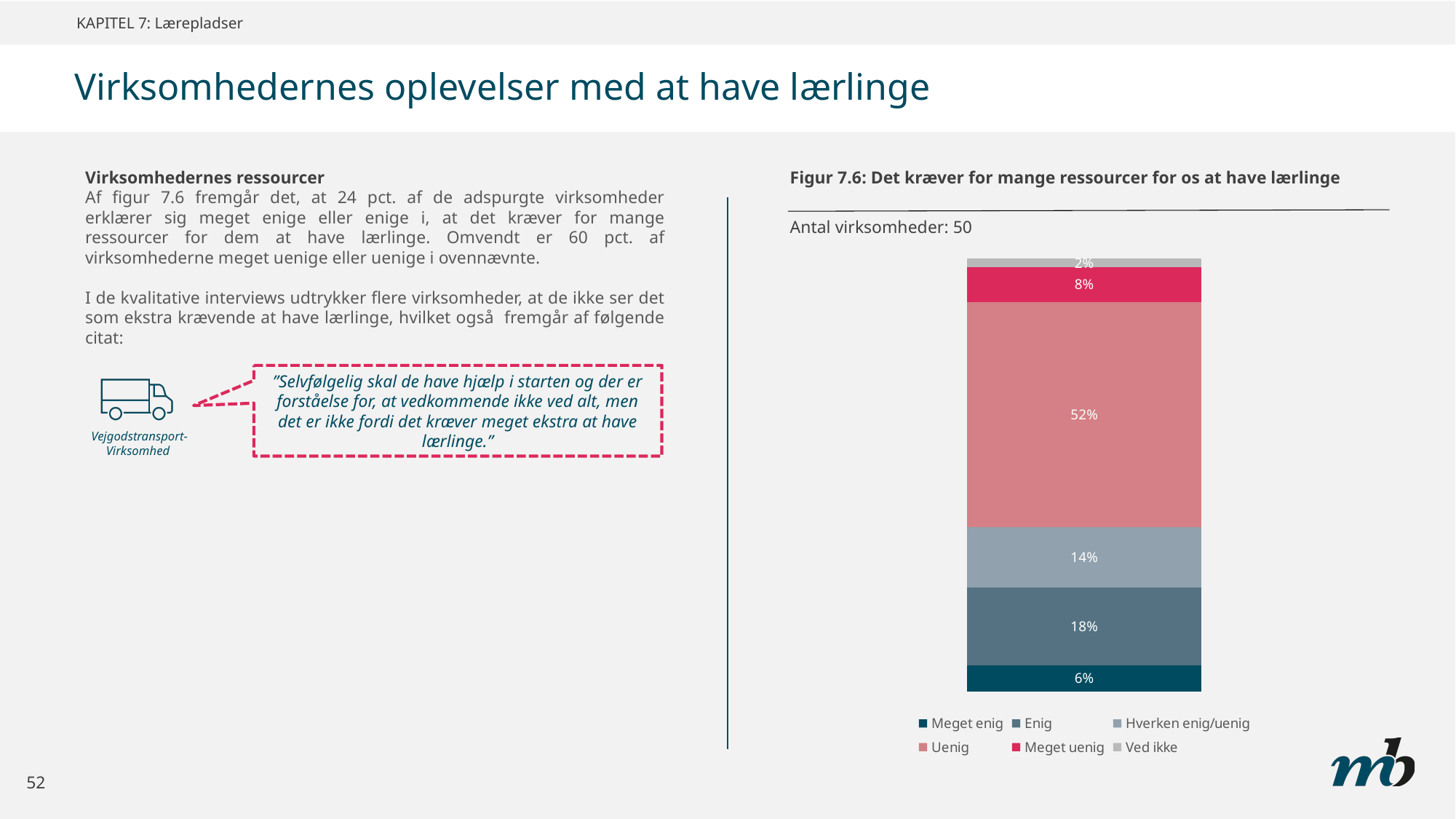
Which is larger, the share for "Meget uenig" or the share for "Hverken enig/uenig"? Hverken enig/uenig What is the value for "Meget enig" in the stacked bar? 6% What percentage of companies answered "Uenig" in Figur 7.6? 52% Which response category has the smallest share in the chart? Ved ikke What is the value shown for "Ved ikke"? 2% What share of companies answered "Hverken enig/uenig"? 14% Which response category has the largest share in the chart? Uenig How many series does the legend list? 6 How many companies (Antal virksomheder) does the chart cover? 50 What kind of chart is shown in Figur 7.6? Stacked bar chart What is the difference between the "Enig" and "Meget enig" shares? 12% What is the combined share of "Meget enig" and "Enig"? 24%